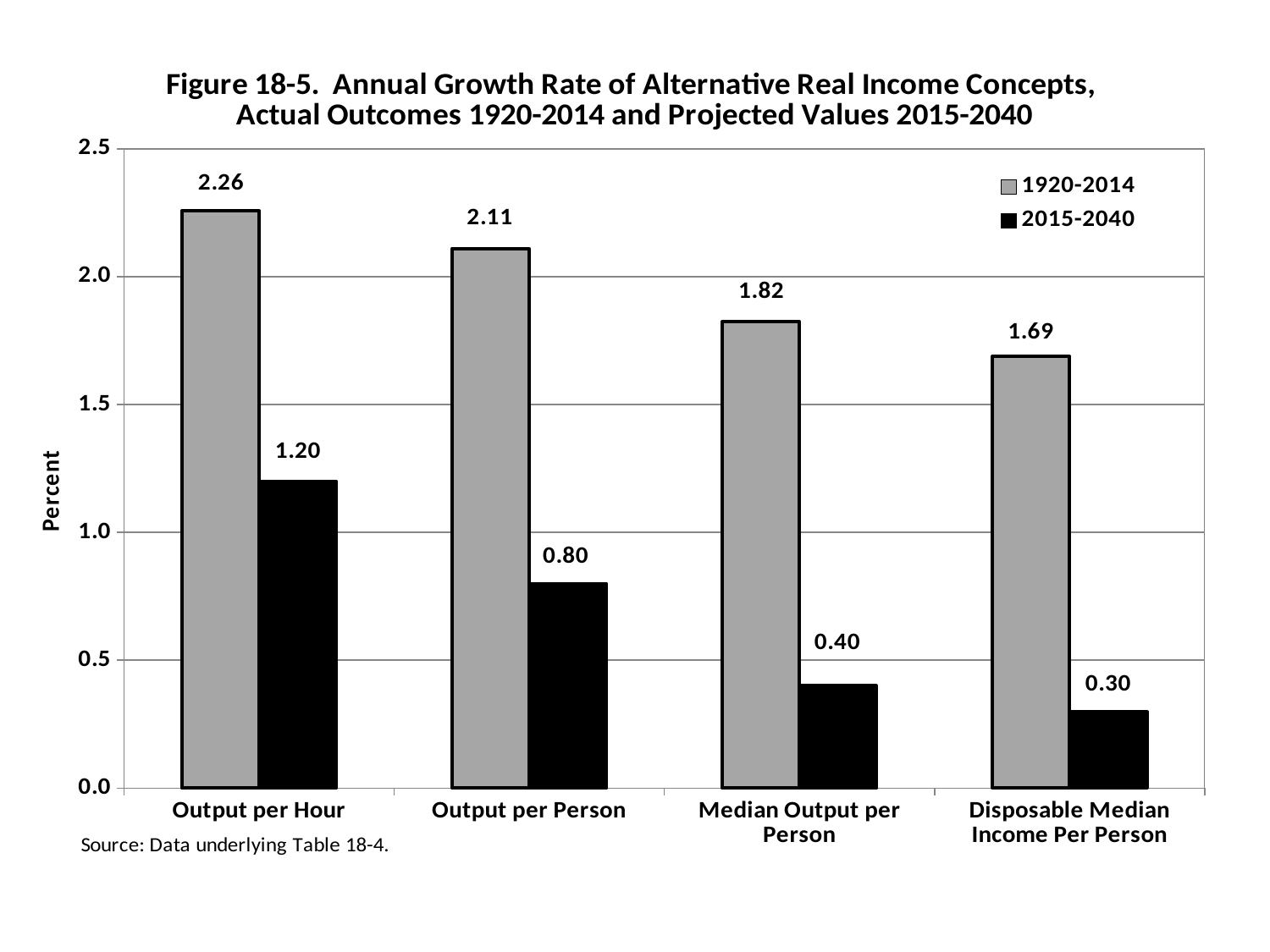
Which is larger: the 2015-2040 value for Output per Hour or the 2015-2040 value for Output per Person? Output per Hour How many series does the legend list? 2 What is the difference between the 1920-2014 and 2015-2040 values for Median Output per Person? 1.42 Do the 1920-2014 values rise or fall from left to right along the x axis? Fall What is the 2015-2040 value for Output per Person? 0.80 How many categories are shown on the x axis? 4 What is the 1920-2014 value for Output per Hour? 2.26 What kind of chart is shown on the slide? Bar chart Which category has the lowest 2015-2040 value? Disposable Median Income Per Person What is the 2015-2040 value for Disposable Median Income Per Person? 0.30 Which category has the highest 1920-2014 value? Output per Hour What is the label of the y axis? Percent